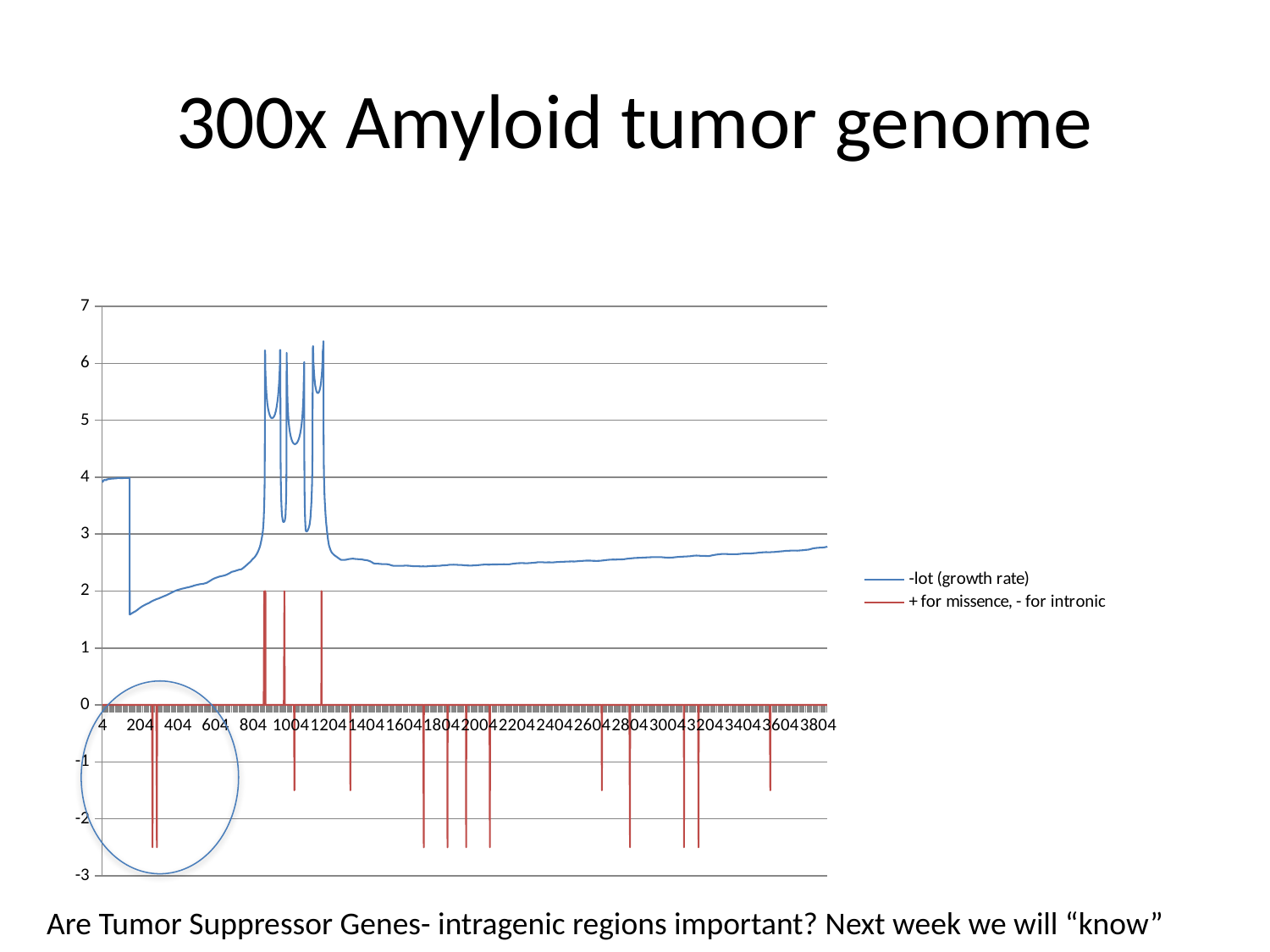
Is the highest peak of the -lot (growth rate) series greater or less than 6? greater What is the title of the chart on the slide? 300x Amyloid tumor genome How many series does the legend list? 2 Which series is drawn in red according to the legend? + for missence, - for intronic Are the positive spikes of the + for missence, - for intronic series between x = 804 and x = 1204 greater or less than 1? greater Is the value of the -lot (growth rate) series at x = 3804 greater or less than 2? greater What kind of chart is shown on the slide? line chart Is the -lot (growth rate) value larger at x = 4 or at x = 3804? x = 4 What is the lowest value shown on the y axis? -3 Does the -lot (growth rate) series rise or fall between x = 1404 and x = 3804? rise